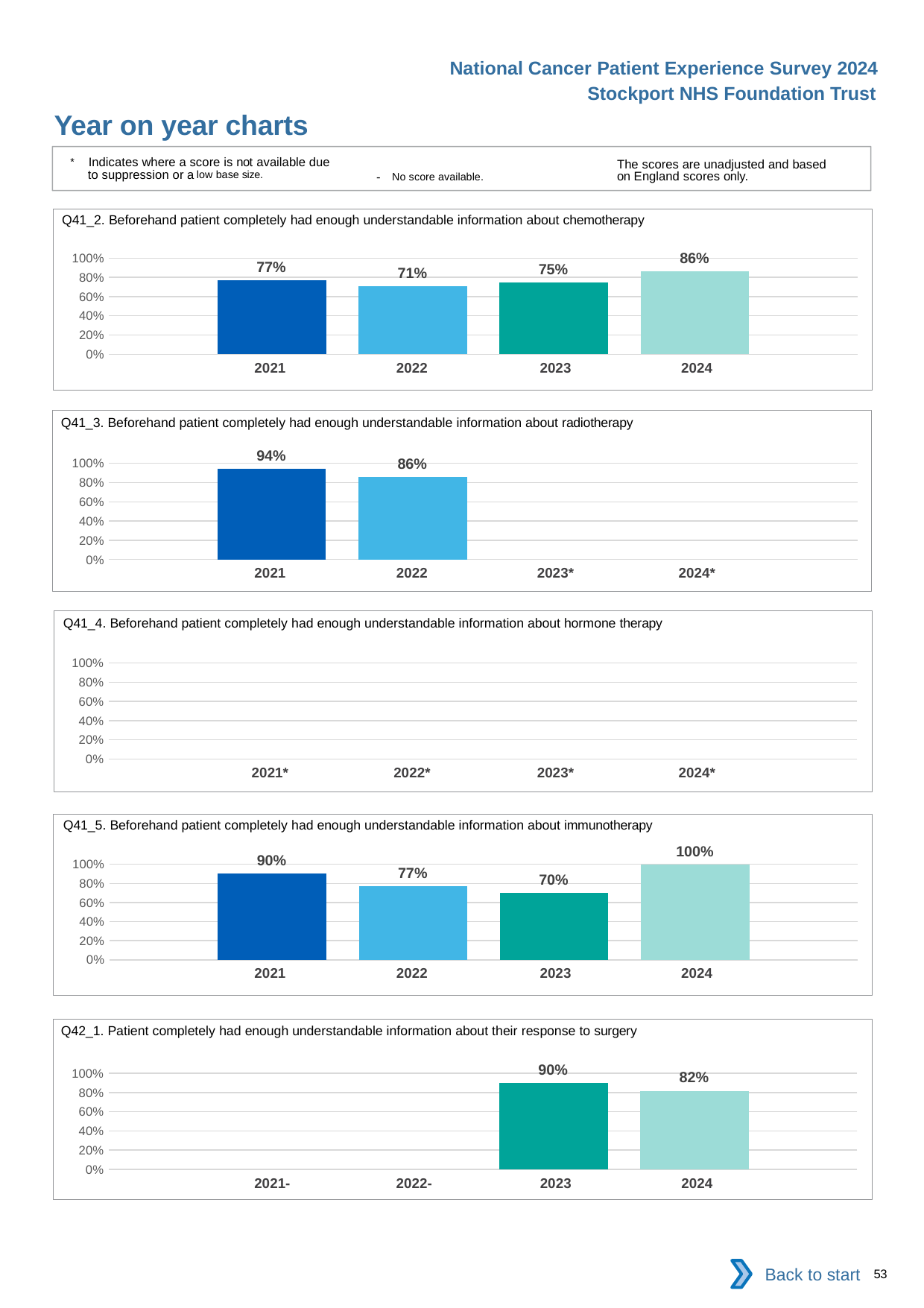
In the Q41_3 chart (radiotherapy), how many years have a bar plotted? 2 In the Q42_1 chart (response to surgery), do the values rise or fall from 2023 to 2024? fall In the Q41_5 chart (immunotherapy), which year has the highest value? 2024 In the Q41_5 chart (immunotherapy), what is the value for 2023? 70% In the Q41_2 chart (chemotherapy), what is the value for 2024? 86% What kind of chart is the Q41_2 chart (chemotherapy)? bar chart In the Q41_3 chart (radiotherapy), what is the value for 2021? 94% In the Q41_5 chart (immunotherapy), which is larger, the value for 2021 or the value for 2022? 2021 In the Q41_2 chart (chemotherapy), which year has the lowest value? 2022 In the Q41_4 chart (hormone therapy), how many bars are plotted? 0 In the Q41_2 chart (chemotherapy), what is the difference between the 2024 and 2021 values? 9 percentage points In the Q42_1 chart (response to surgery), what is the difference between the 2023 and 2024 values? 8 percentage points